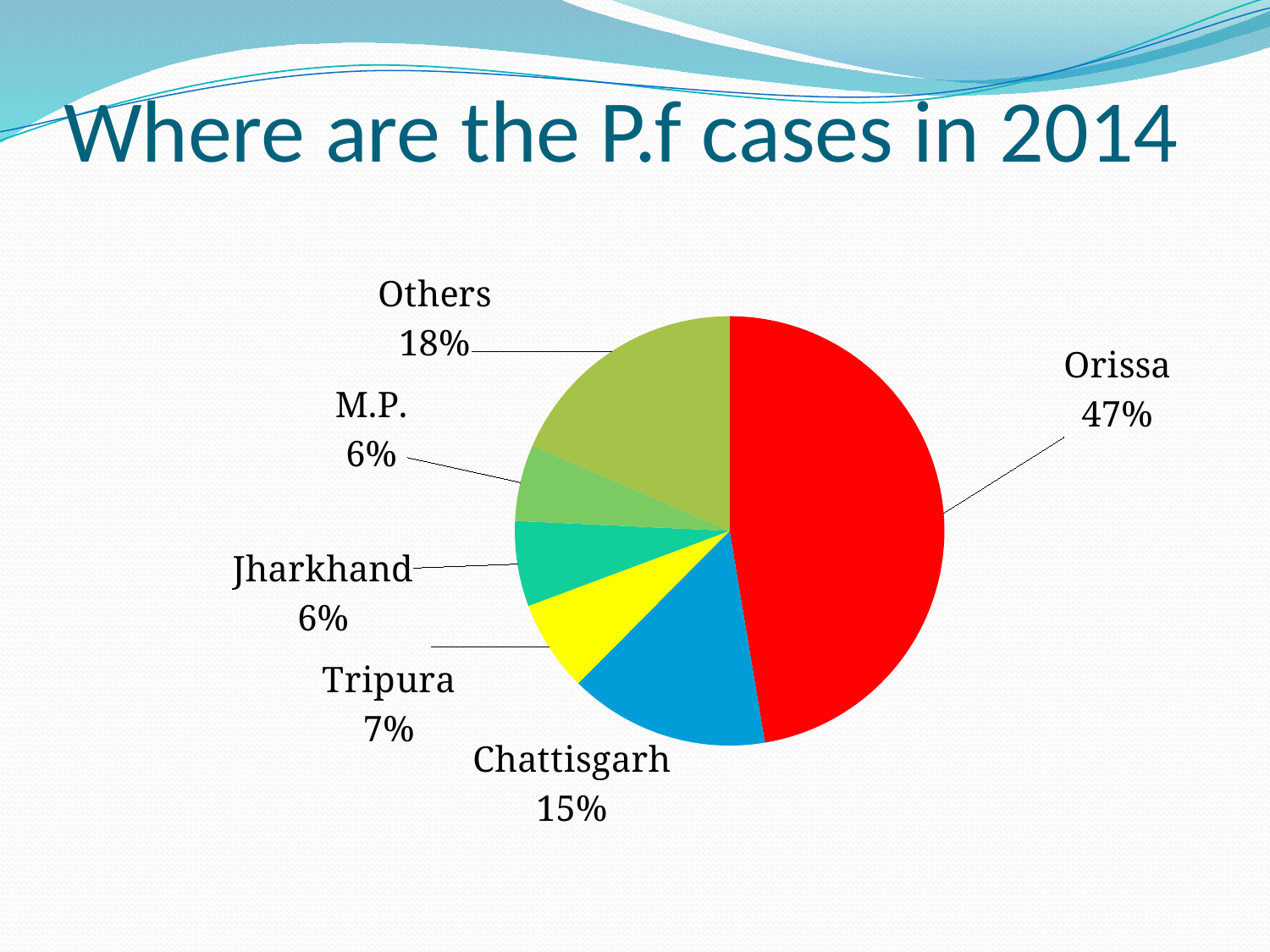
What share of P.f cases in 2014 does Orissa account for? 47% Which state has the largest share of P.f cases in 2014? Orissa How many slices does the pie chart have? 6 What is the share shown for Tripura? 7% What type of chart is shown on the slide? Pie chart What percentage of P.f cases is attributed to Chattisgarh? 15% What is the title of the slide? Where are the P.f cases in 2014 What is the difference in percentage points between Others and M.P.? 12 Which is larger, the Others slice or the Chattisgarh slice? Others What is the difference in percentage points between Orissa and Chattisgarh? 32 Which slice is larger, Chattisgarh or Tripura? Chattisgarh What percentage is shown for Others? 18%